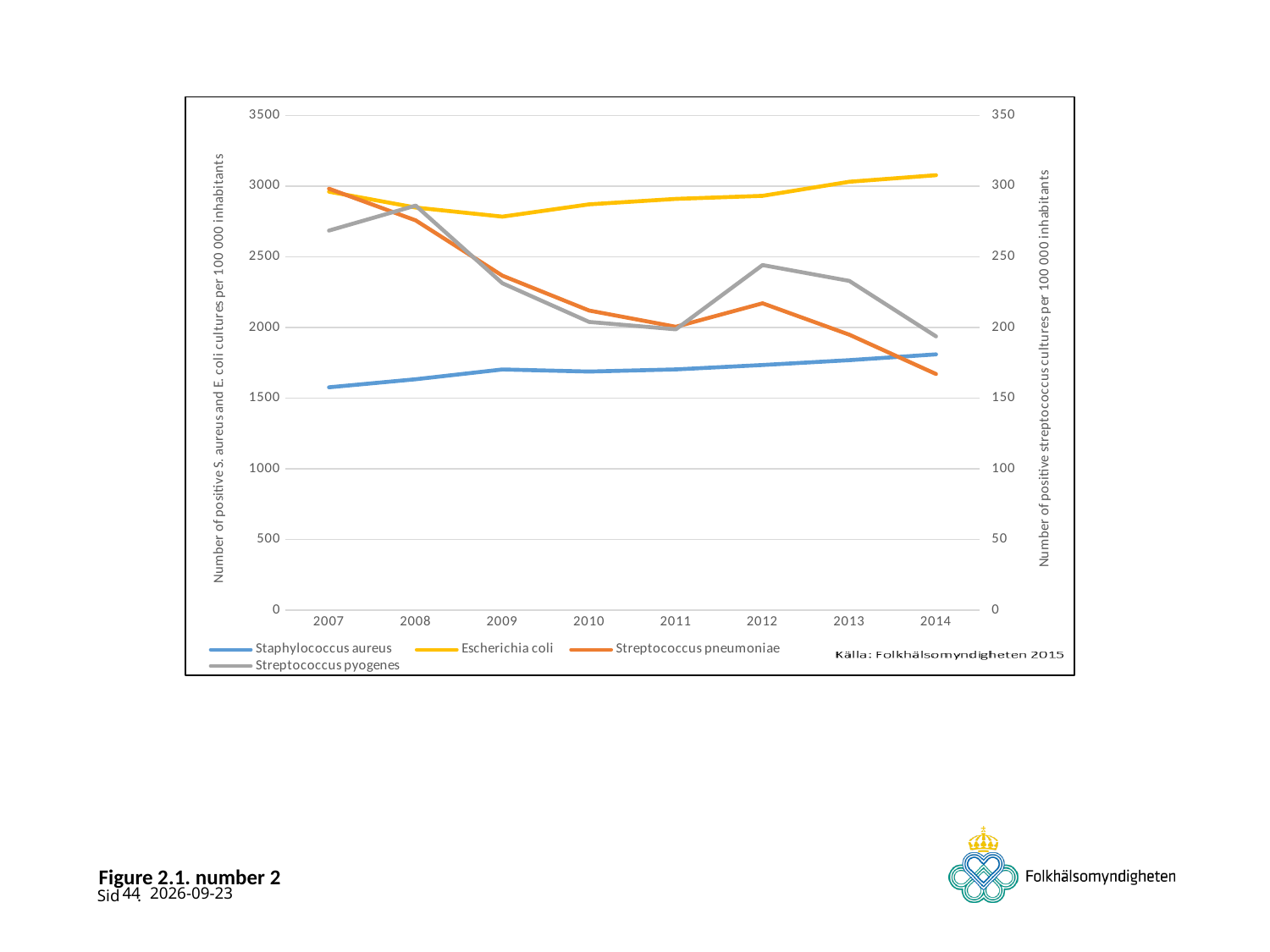
Does the Staphylococcus aureus line rise or fall from 2007 to 2014? rise Does the Streptococcus pneumoniae line rise or fall from 2007 to 2014? fall What kind of chart is shown on the slide? line chart Is the value for Escherichia coli in 2014 greater or less than 3000? greater Which year has the lowest value for Streptococcus pneumoniae? 2014 Is the value for Staphylococcus aureus in 2007 greater or less than 2000? less What source is cited in the chart? Källa: Folkhälsomyndigheten 2015 Which year has the highest value for Escherichia coli? 2014 Which year has the lowest value for Staphylococcus aureus? 2007 Which year has the highest value for Streptococcus pneumoniae? 2007 How many years are shown on the x axis? 8 How many series does the legend list? 4